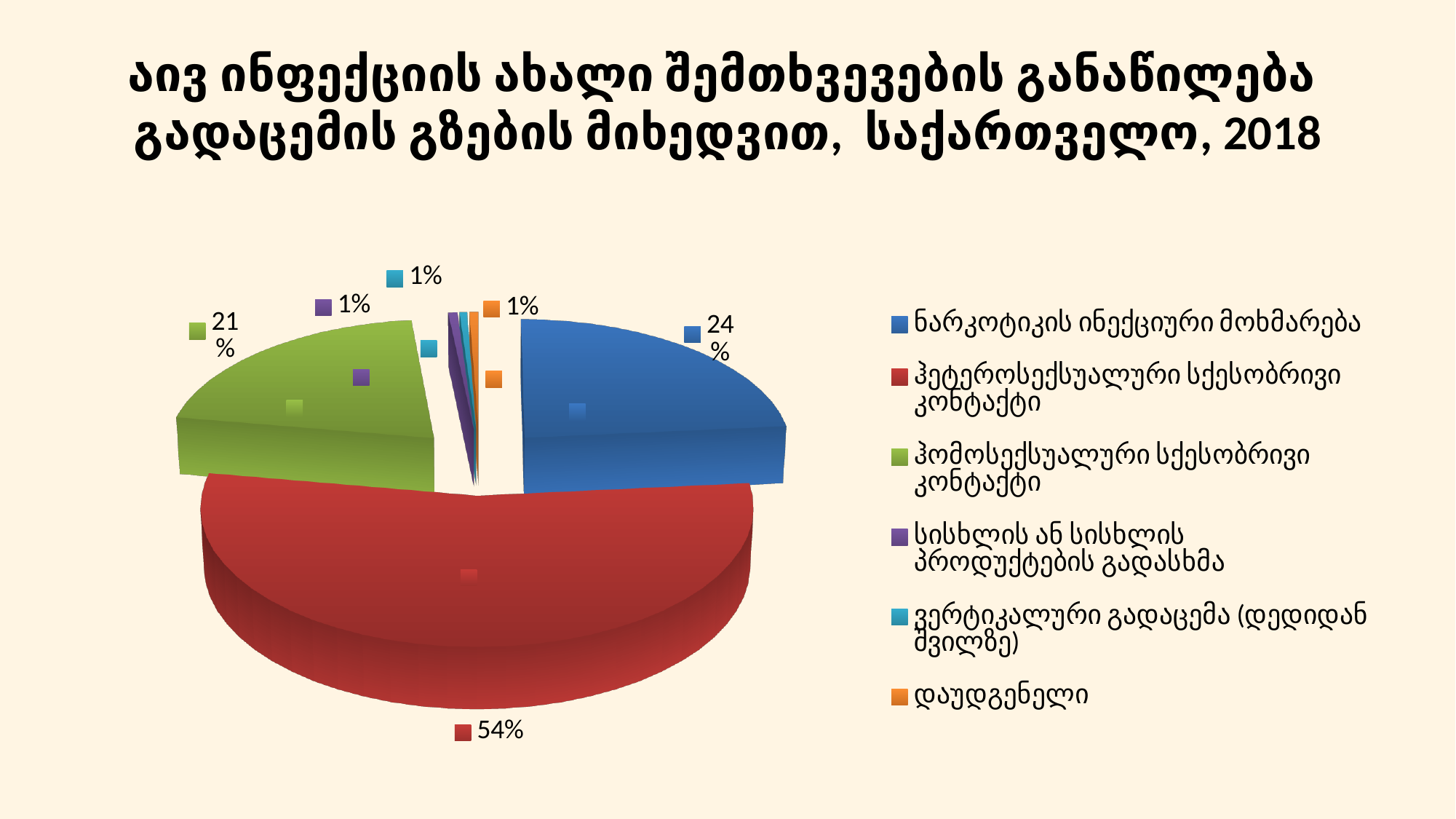
What is the combined share of the ნარკოტიკის ინექციური მოხმარება and ჰომოსექსუალური სქესობრივი კონტაქტი slices? 45% What percentage is shown for დაუდგენელი (the orange slice)? 1% What percentage of the pie is labelled for ჰეტეროსექსუალური სქესობრივი კონტაქტი (the red slice)? 54% What percentage is shown for ნარკოტიკის ინექციური მოხმარება (the blue slice)? 24% How many categories does the legend of the pie chart list? 6 What is the difference in percentage points between the ჰეტეროსექსუალური სქესობრივი კონტაქტი slice and the ნარკოტიკის ინექციური მოხმარება slice? 30 percentage points What year is given in the chart title? 2018 What percentage is shown for ჰომოსექსუალური სქესობრივი კონტაქტი (the green slice)? 21% How many slices are labelled 1%? 3 Which is larger: the share for ნარკოტიკის ინექციური მოხმარება or the share for ჰომოსექსუალური სქესობრივი კონტაქტი? ნარკოტიკის ინექციური მოხმარება Which category has the largest share of the pie? ჰეტეროსექსუალური სქესობრივი კონტაქტი What kind of chart is shown on the slide? Pie chart